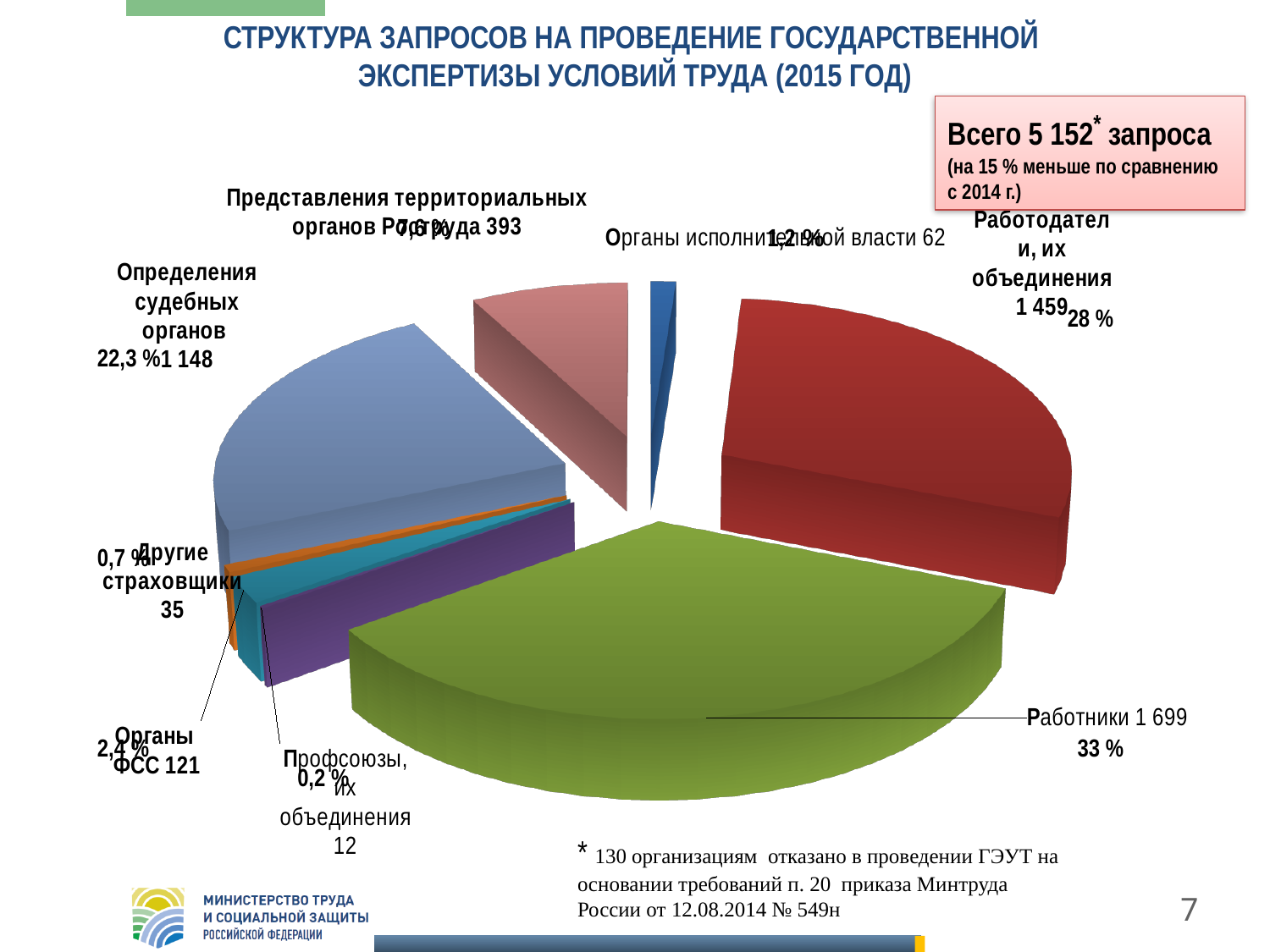
How many requests came from Работодатели и их объединения? 1 459 What is the difference between the number of requests from Работники and from Работодатели и их объединения? 240 How many categories does the pie chart show? 8 How many requests came from Органы ФСС? 121 Which category has the largest number of requests? Работники How many requests were Определения судебных органов? 1 148 Which category has the smallest number of requests? Профсоюзы, их объединения What share of requests came from Работники? 33 % How many requests came from Работники (workers)? 1 699 What kind of chart is shown on the slide? pie chart What share of requests were Определения судебных органов? 22,3 % Which is larger: requests from Органы ФСС or from Органы исполнительной власти? Органы ФСС